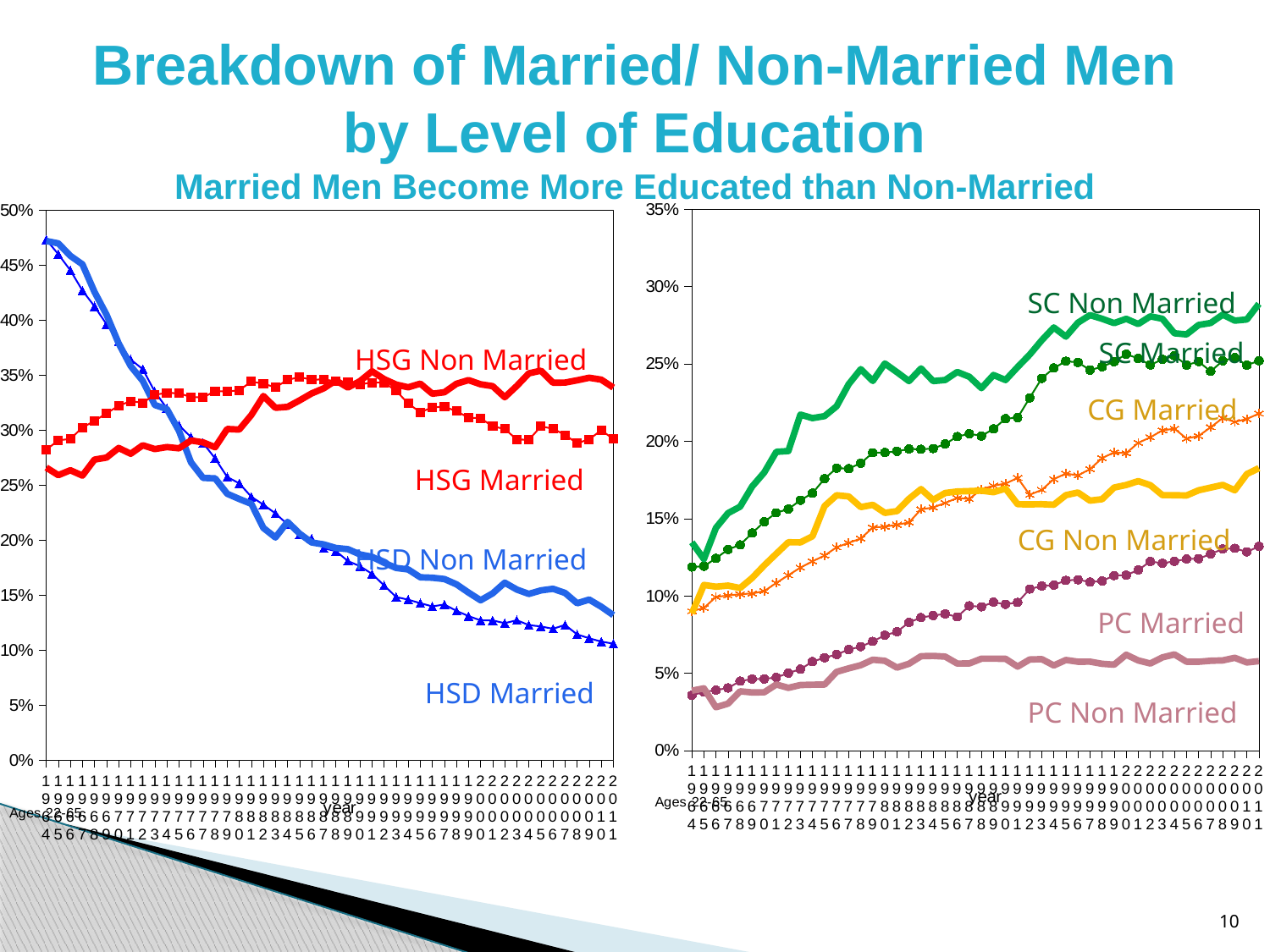
On the right chart, is the value for PC Non Married in 2011 greater or less than 10%? less On the left chart, does the HSD Married line rise or fall from 1964 to 2011? fall On the right chart, is the value for SC Non Married in 2011 greater or less than 25%? greater What is the highest value shown on the vertical axis of the right chart? 35% On the left chart, which is larger in 2011: HSG Married or HSD Married? HSG Married On the left chart, is the value for HSD Married in 2011 greater or less than 15%? less On the right chart, which is larger in 2011: SC Non Married or PC Non Married? SC Non Married On the right chart, does the SC Non Married line rise or fall from 1964 to 2011? rise What kind of chart is the left chart on the slide? line chart